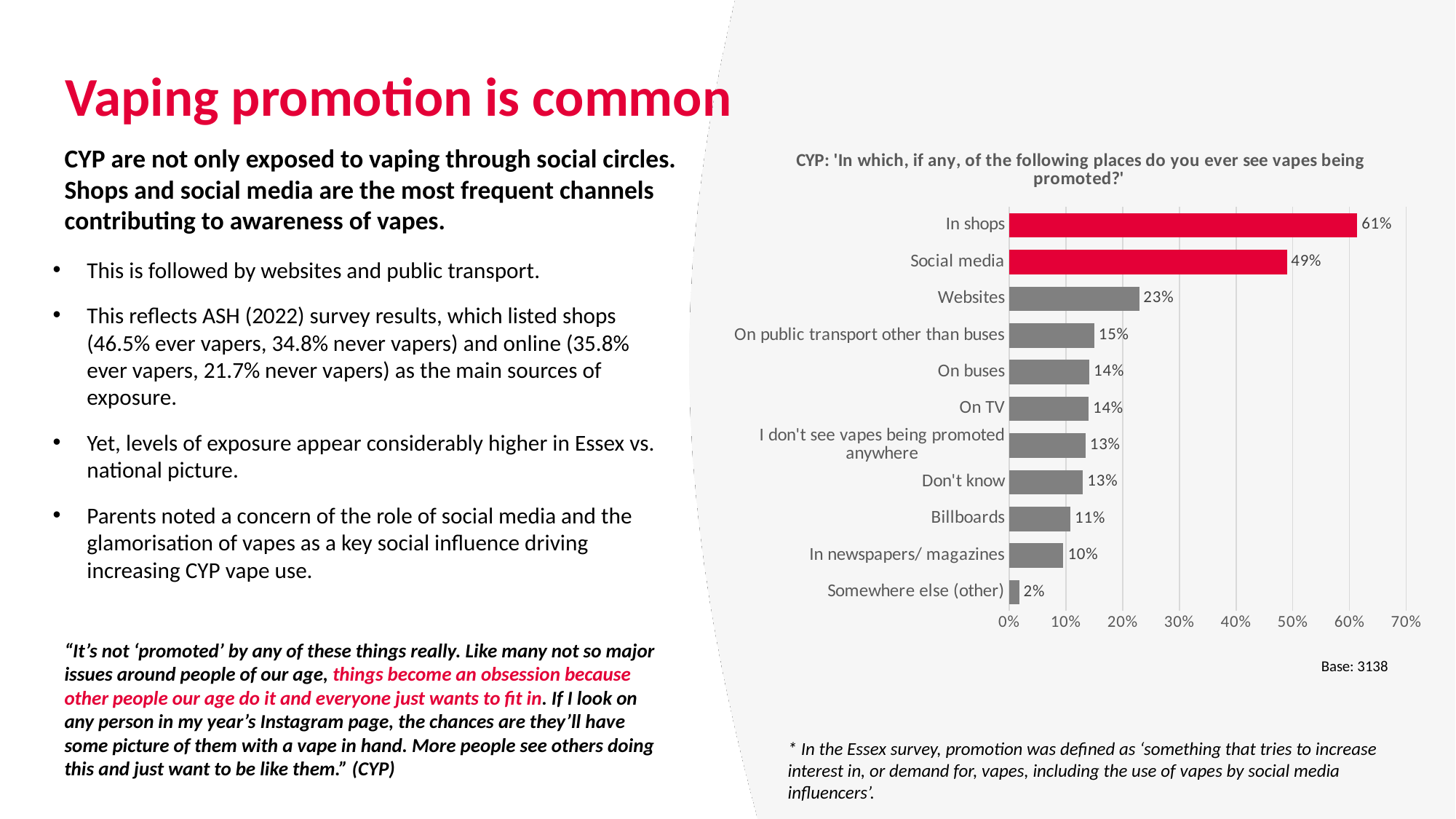
Which two bars in the chart are coloured red rather than grey? In shops and Social media Which category has the lowest value in the chart? Somewhere else (other) What percentage of CYP said they see vapes being promoted in shops? 61% How many categories are shown in the chart? 11 What is the value for 'Websites' in the chart? 23% Is the value for 'Social media' greater or less than 40%? greater What is the difference between the values for 'In shops' and 'Social media'? 12% Which category has the highest value in the chart? In shops Which is larger: the value for 'Websites' or the value for 'On buses'? Websites What is the value for 'In newspapers/ magazines'? 10% What is the value for 'Billboards' in the chart? 11% What kind of chart is shown on the slide? Bar chart